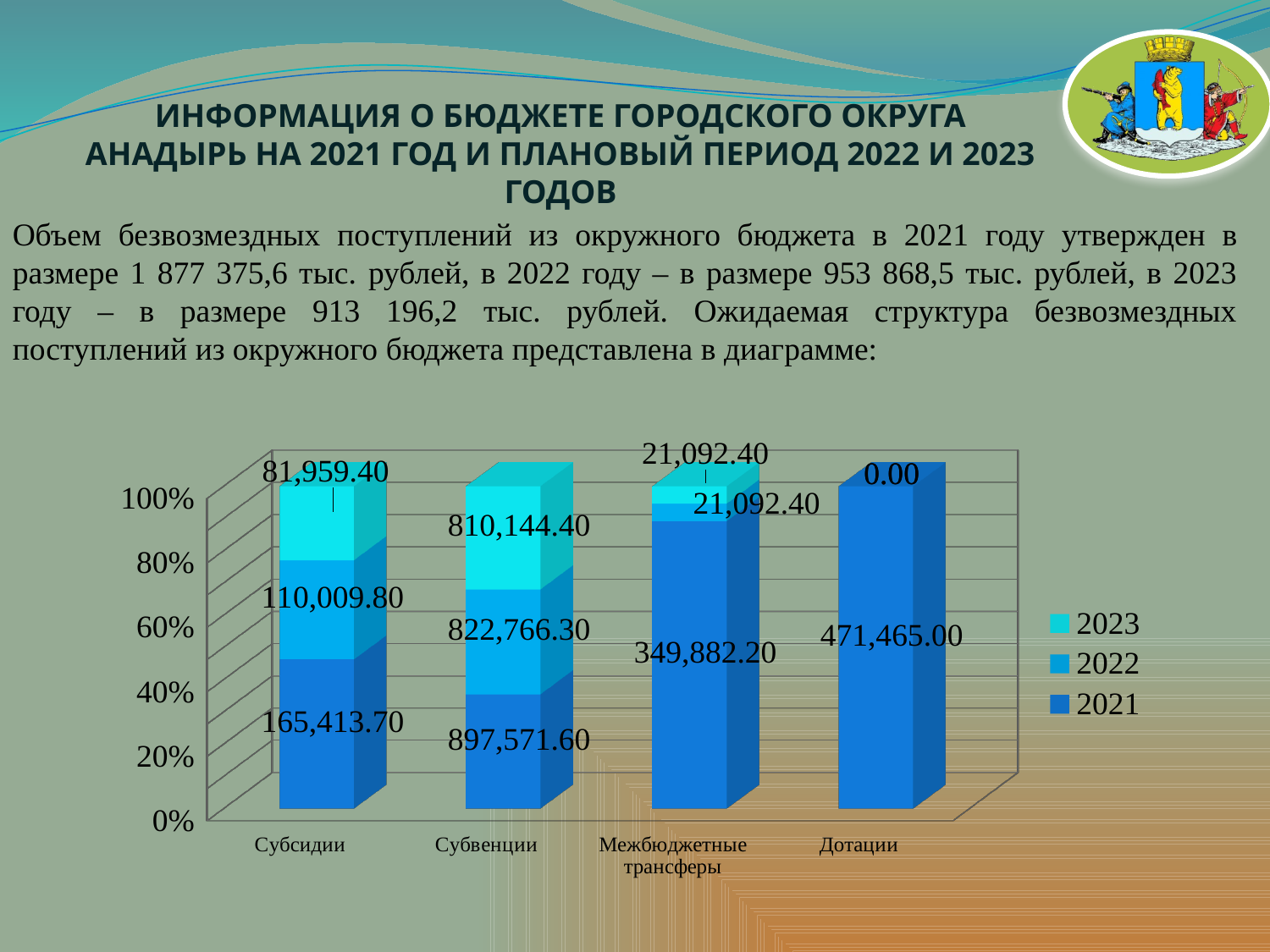
How many series does the legend list? 3 What is the value for Субвенции in the 2023 series? 810,144.40 What is the total of the three values in the Субвенции bar? 2,530,482.30 How many categories are shown on the x axis? 4 What is the value for Субсидии in the 2021 series? 165,413.70 What kind of chart is shown on the slide? Stacked bar chart What is the value for Межбюджетные трансферы in the 2022 series? 21,092.40 What is the value for Дотации in the 2021 series? 471,465.00 Which category has the highest value in the 2021 series? Субвенции Which is larger in the 2021 series: Межбюджетные трансферы or Дотации? Дотации What is the difference between the 2021 and 2022 values for Субсидии? 55,403.90 Which category has the lowest value in the 2021 series? Субсидии